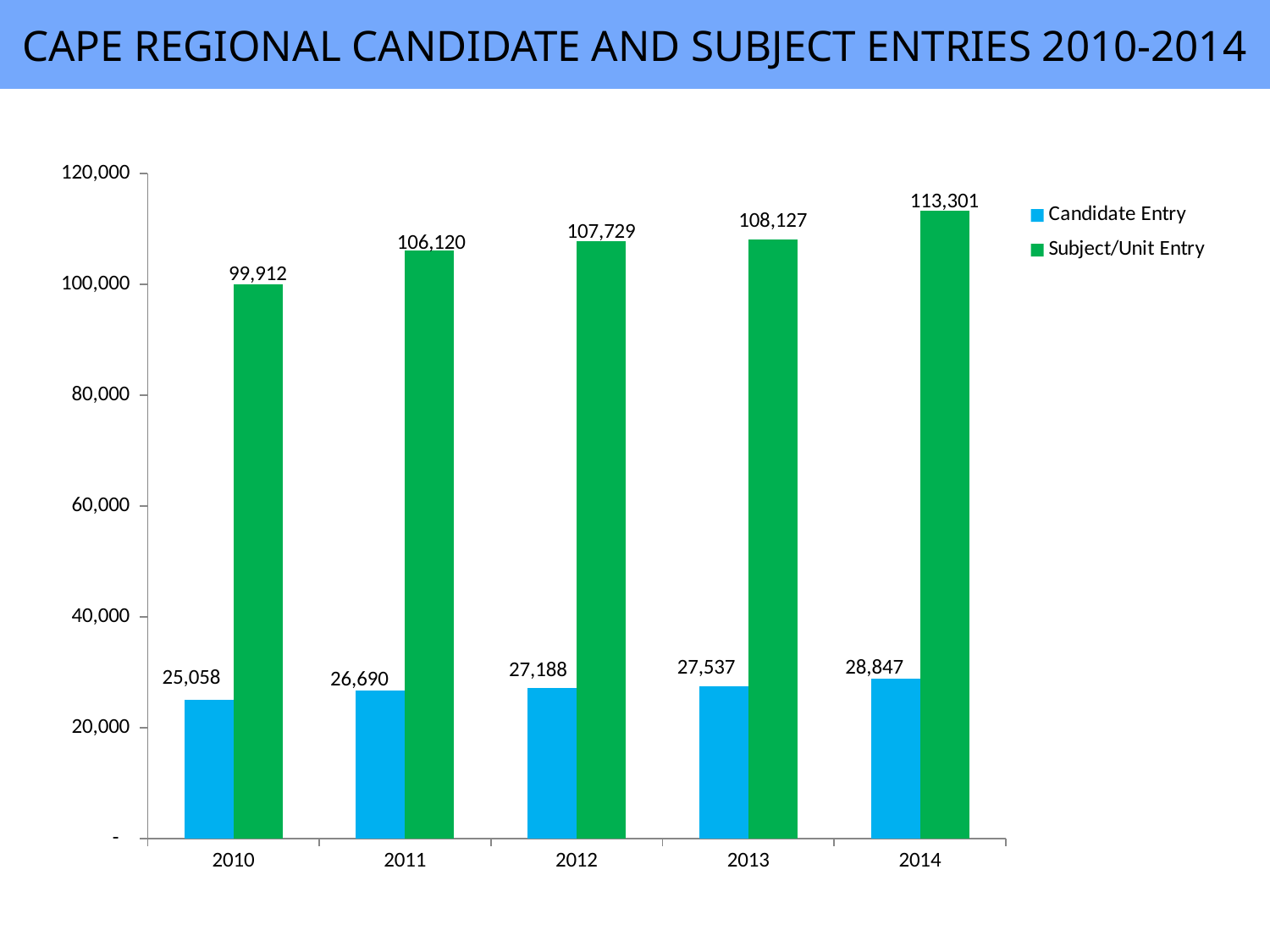
Which year has the lowest Subject/Unit Entry? 2010 What kind of chart is shown on the slide? Bar chart How many years are shown on the x axis? 5 Does the Subject/Unit Entry rise or fall from 2010 to 2014? Rise Which year has the highest Candidate Entry? 2014 What is the difference between the Candidate Entry in 2014 and in 2010? 3,789 What is the Subject/Unit Entry value for 2011? 106,120 Which is larger, the Candidate Entry in 2013 or the Candidate Entry in 2011? 2013 What is the difference between the Subject/Unit Entry in 2014 and in 2010? 13,389 How many series does the legend list? 2 What is the Subject/Unit Entry value for 2014? 113,301 What is the Candidate Entry value for 2012? 27,188